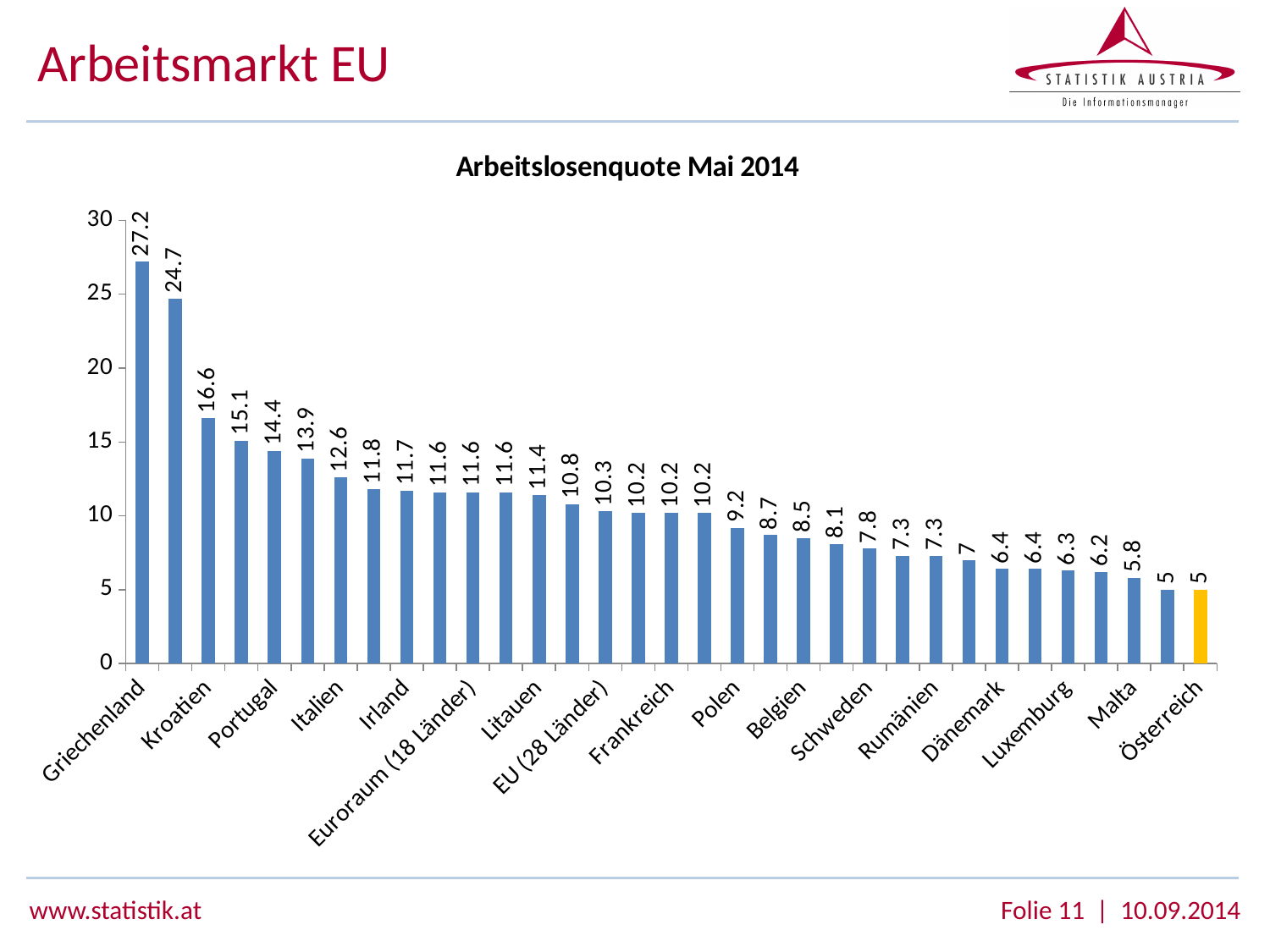
Do the values rise or fall from left to right along the x axis? fall What type of chart is shown on the slide? bar chart What is the title of the chart? Arbeitslosenquote Mai 2014 Is the value for Frankreich greater or less than 15? less What is the unemployment rate shown for Griechenland? 27.2 Which category has the highest value in the chart? Griechenland How many bars are plotted in the chart? 33 What is the value shown for EU (28 Länder)? 10.3 What is the difference between the values for Griechenland and Österreich? 22.2 What is the value shown for Österreich? 5 What is the value shown for Euroraum (18 Länder)? 11.6 Which has a higher value, Kroatien or Portugal? Kroatien